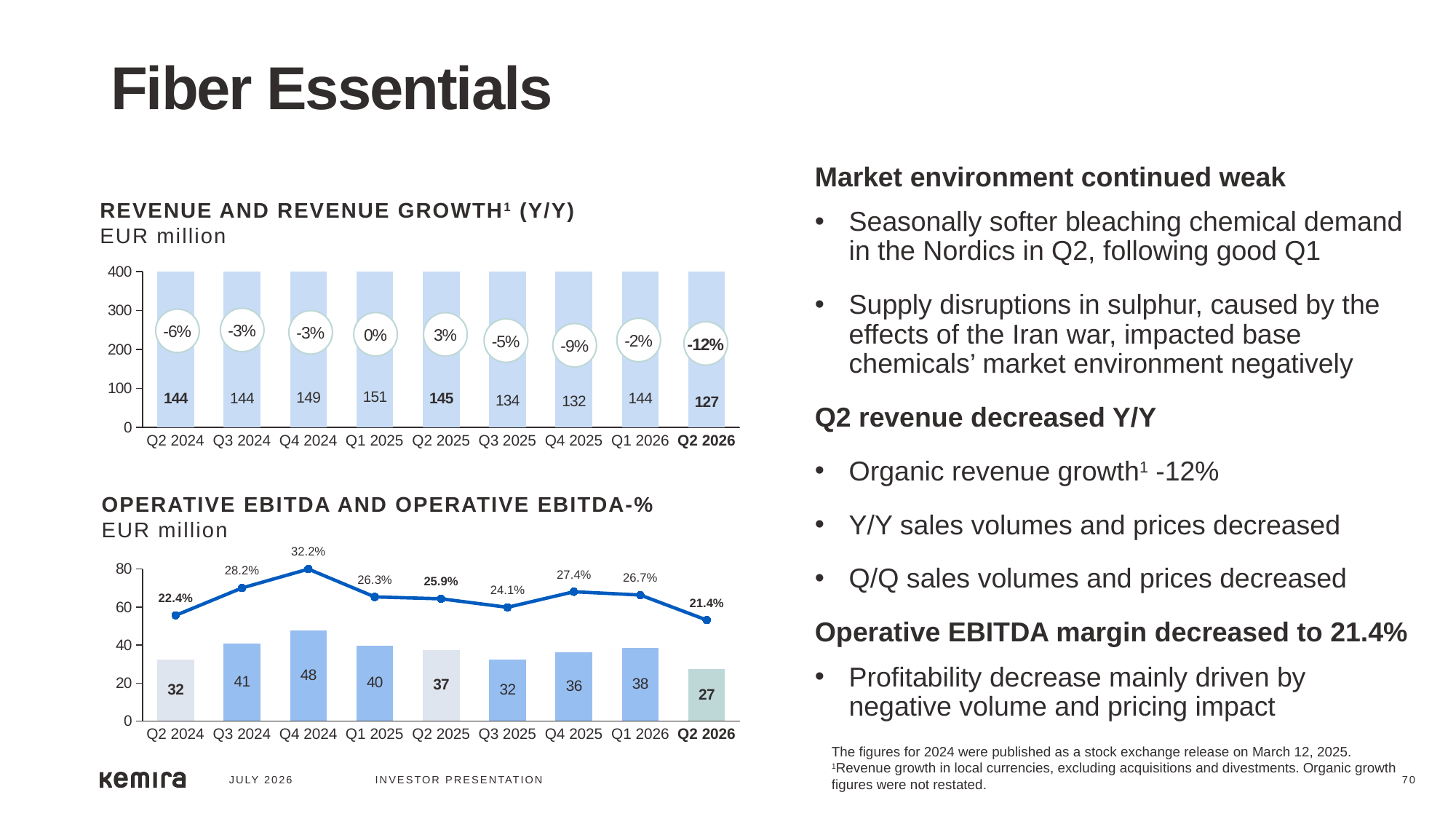
In the 'Operative EBITDA and operative EBITDA-%' chart, what is the difference in operative EBITDA between Q4 2024 and Q2 2026? 21 In the 'Revenue and revenue growth' chart, what was revenue in Q1 2025? 151 What kind of chart is the 'Operative EBITDA and operative EBITDA-%' chart? Combined bar and line chart In the 'Revenue and revenue growth' chart, how many quarters are shown? 9 In the 'Operative EBITDA and operative EBITDA-%' chart, which quarter had the highest operative EBITDA-%? Q4 2024 In the 'Operative EBITDA and operative EBITDA-%' chart, which is larger, operative EBITDA in Q1 2026 or in Q2 2026? Q1 2026 In the 'Revenue and revenue growth' chart, what is the difference in revenue between Q2 2025 and Q2 2026? 18 In the 'Revenue and revenue growth' chart, which quarter had the lowest revenue? Q2 2026 In the 'Operative EBITDA and operative EBITDA-%' chart, what was the operative EBITDA-% in Q3 2025? 24.1% In the 'Revenue and revenue growth' chart, what was the revenue growth in Q2 2026? -12% In the 'Operative EBITDA and operative EBITDA-%' chart, what was operative EBITDA in Q4 2024? 48 In the 'Revenue and revenue growth' chart, which quarter had the highest revenue? Q1 2025